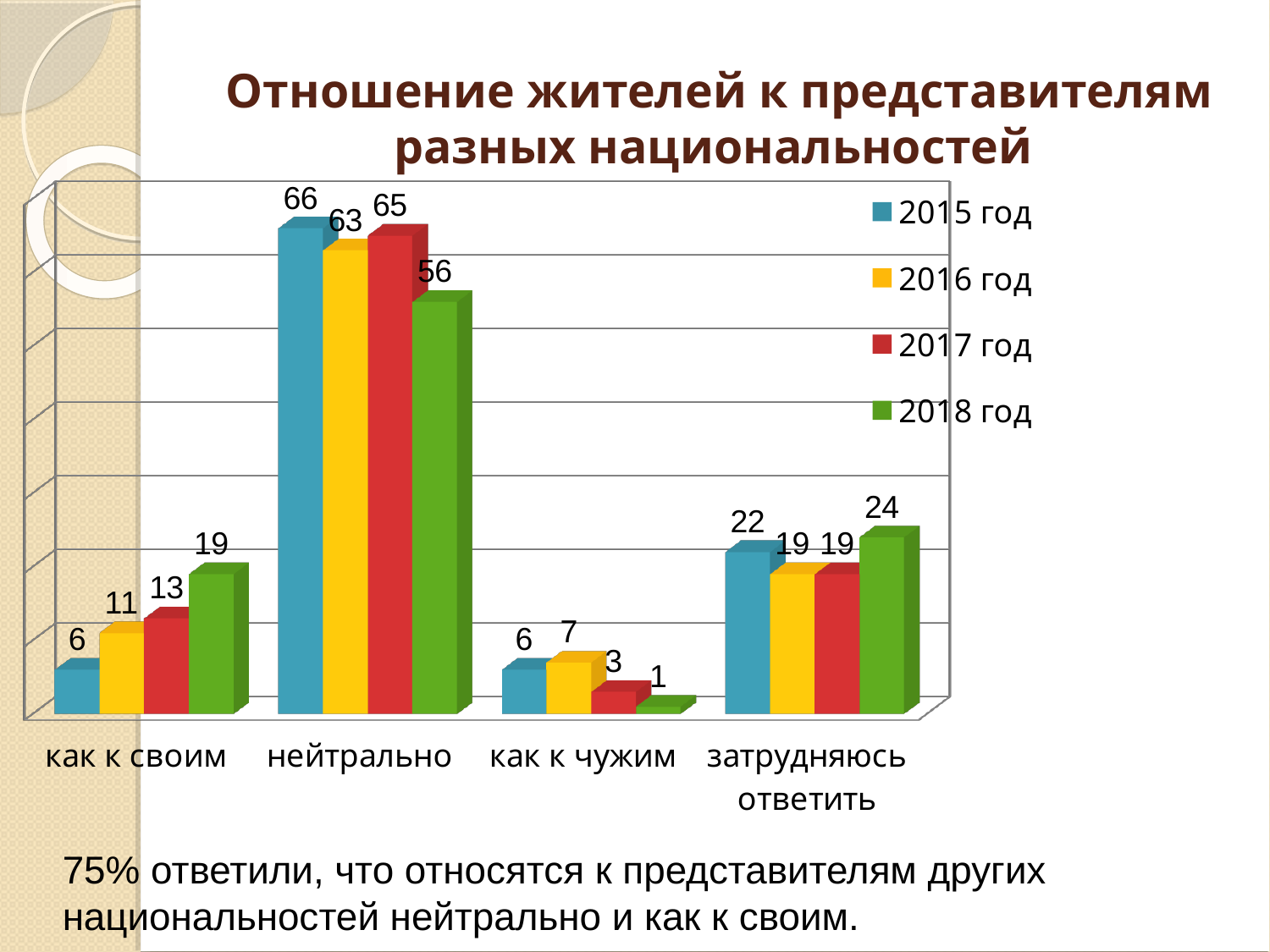
What is the value for 2015 год in the нейтрально category? 66 Do the values for the как к своим category rise or fall from 2015 год to 2018 год? rise What is the value for 2018 год in the как к своим category? 19 What is the value for 2016 год in the затрудняюсь ответить category? 19 What kind of chart is shown on the slide? bar chart How many categories are shown on the x axis? 4 Which category has the lowest value for 2018 год? как к чужим What is the value for 2017 год in the как к чужим category? 3 How many series does the legend list? 4 Which is larger in the как к своим category: the value for 2016 год or the value for 2017 год? 2017 год Which category has the highest value for 2018 год? нейтрально What is the difference between the 2015 год and 2018 год values in the нейтрально category? 10